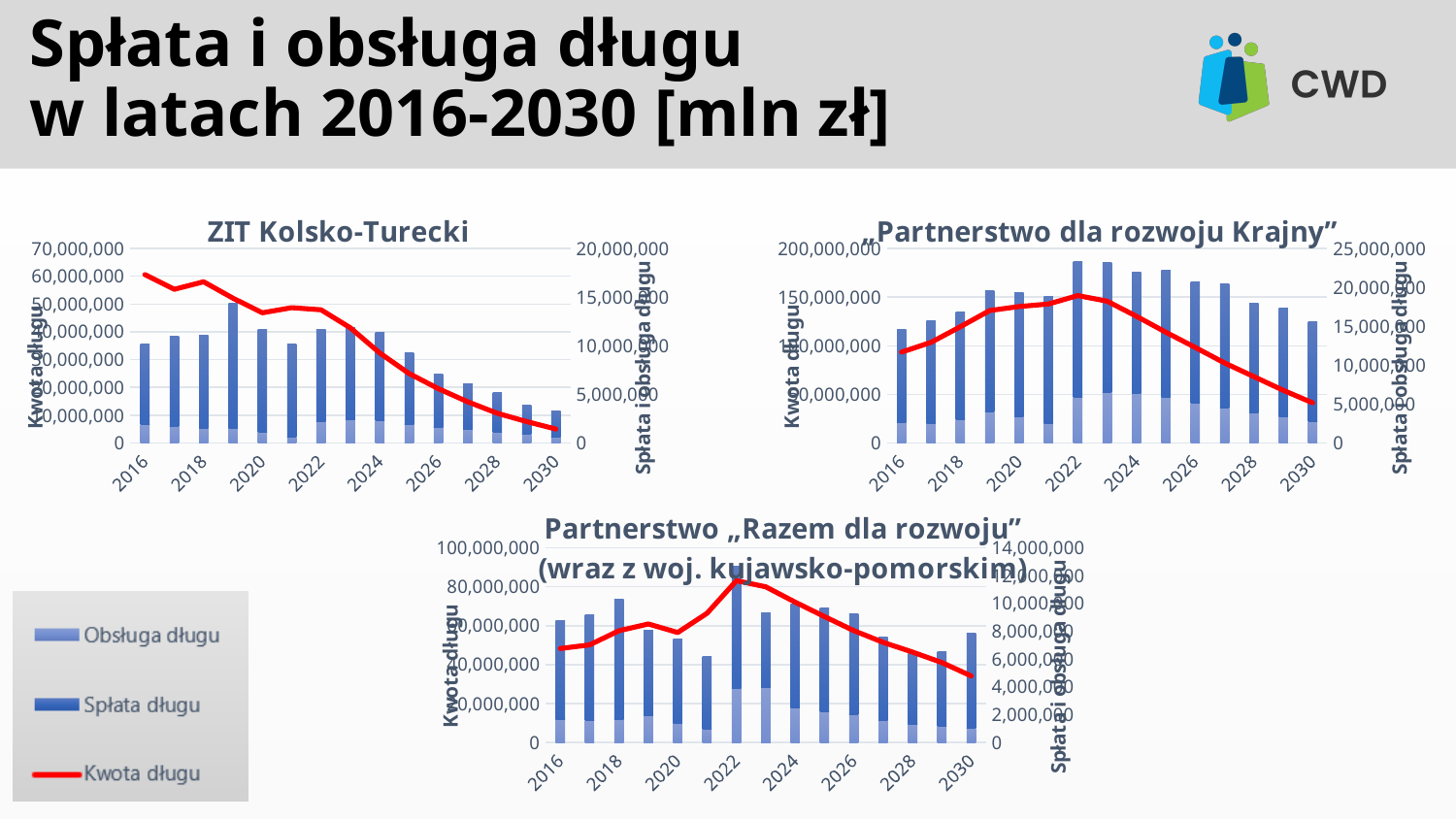
What kind of chart is the 'ZIT Kolsko-Turecki' chart? Combined bar and line chart In the 'Partnerstwo dla rozwoju Krajny' chart, is the Kwota długu value for 2030 greater or less than 100,000,000? less In the 'ZIT Kolsko-Turecki' chart, is the Kwota długu value for 2016 greater or less than 50,000,000? greater In the 'Partnerstwo dla rozwoju Krajny' chart, in which year does the Kwota długu line reach its peak? 2022 In the 'ZIT Kolsko-Turecki' chart, which year has the tallest stacked bar? 2019 In the 'Partnerstwo „Razem dla rozwoju”' chart, which year has the shortest stacked bar? 2021 In the 'ZIT Kolsko-Turecki' chart, how many years are plotted on the x axis? 15 How many series does the legend on the slide list? 3 How many charts are shown on the slide? 3 In the 'Partnerstwo „Razem dla rozwoju”' chart, which year has the tallest stacked bar? 2022 In the 'Partnerstwo dla rozwoju Krajny' chart, is the Kwota długu value for 2022 greater or less than 100,000,000? greater In the 'ZIT Kolsko-Turecki' chart, does the Kwota długu line rise or fall from 2016 to 2030? Falls